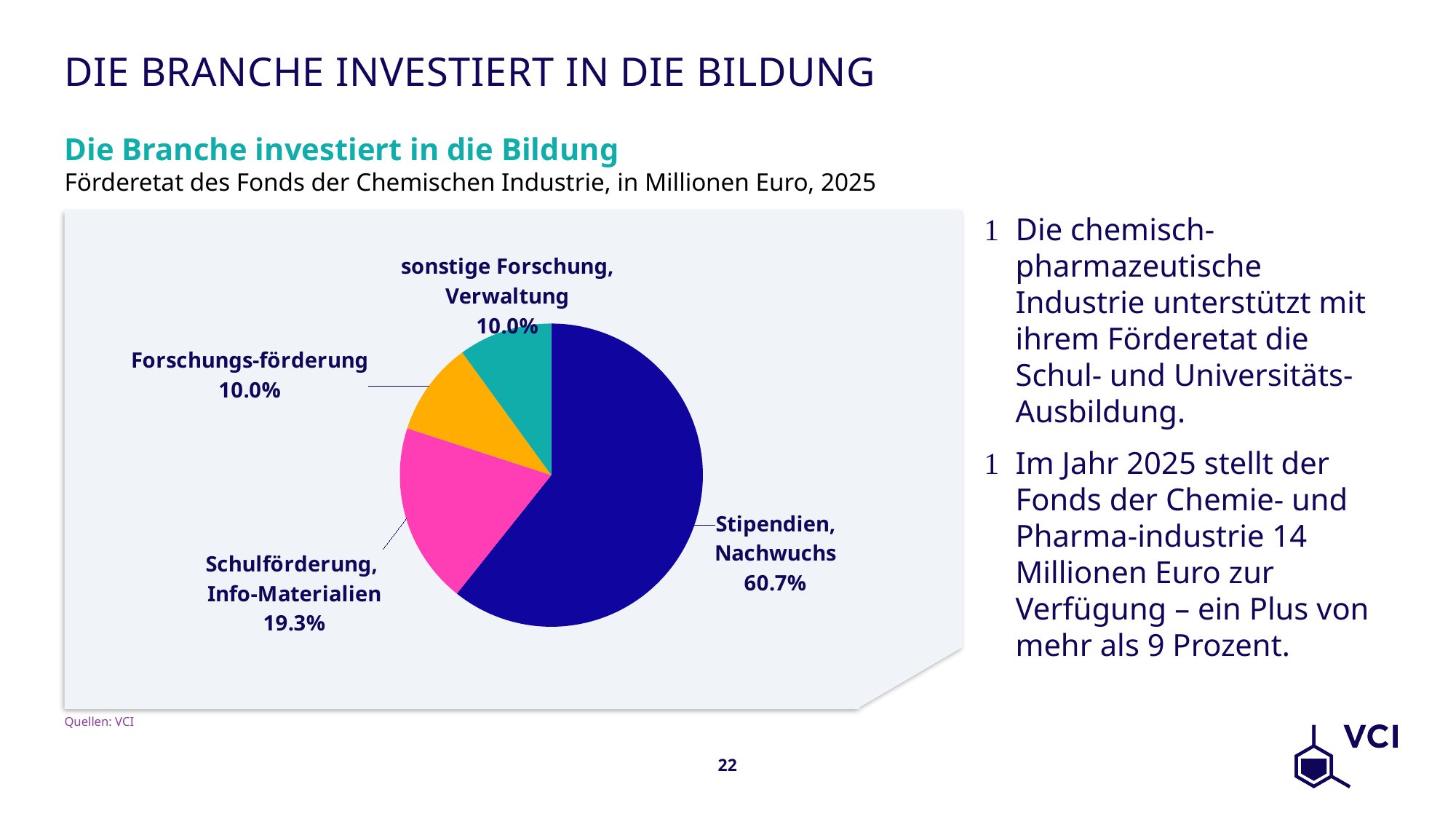
What share of the pie does Schulförderung, Info-Materialien have? 19.3% Which category has the second-largest slice of the pie? Schulförderung, Info-Materialien What share of the pie does Forschungs-förderung have? 10.0% What share of the pie does Stipendien, Nachwuchs have? 60.7% Which category has the largest slice of the pie? Stipendien, Nachwuchs Which is larger: Schulförderung, Info-Materialien or Forschungs-förderung? Schulförderung, Info-Materialien How many categories are shown in the pie chart? 4 What kind of chart is shown on the slide? Pie chart What is the difference in percentage points between Stipendien, Nachwuchs and Schulförderung, Info-Materialien? 41.4 What is the title of the chart? Die Branche investiert in die Bildung What colour is the Stipendien, Nachwuchs slice? Dark blue